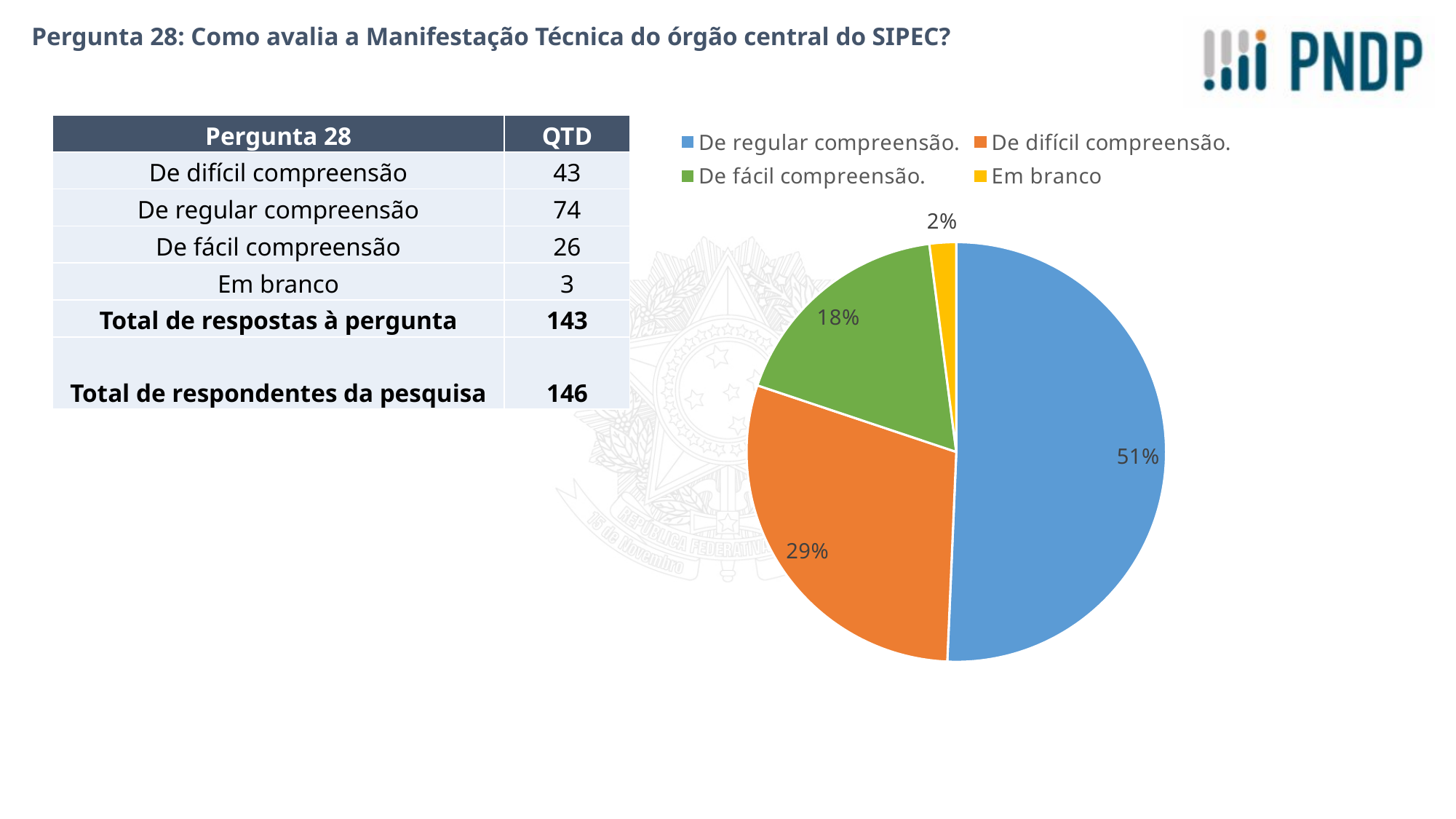
What percentage of the pie does "De difícil compreensão." represent? 29% What colour is the "Em branco" slice in the pie chart? yellow How many entries does the legend list? 4 Which category has the smallest slice of the pie? Em branco What kind of chart is shown on the slide? pie chart What is the difference in percentage points between the "De regular compreensão." slice and the "De difícil compreensão." slice? 22 percentage points Which slice is larger, "De difícil compreensão." or "De fácil compreensão."? De difícil compreensão. How many slices does the pie chart have? 4 What percentage of the pie does "Em branco" represent? 2% What percentage of the pie does "De fácil compreensão." represent? 18% Which category has the largest slice of the pie? De regular compreensão.